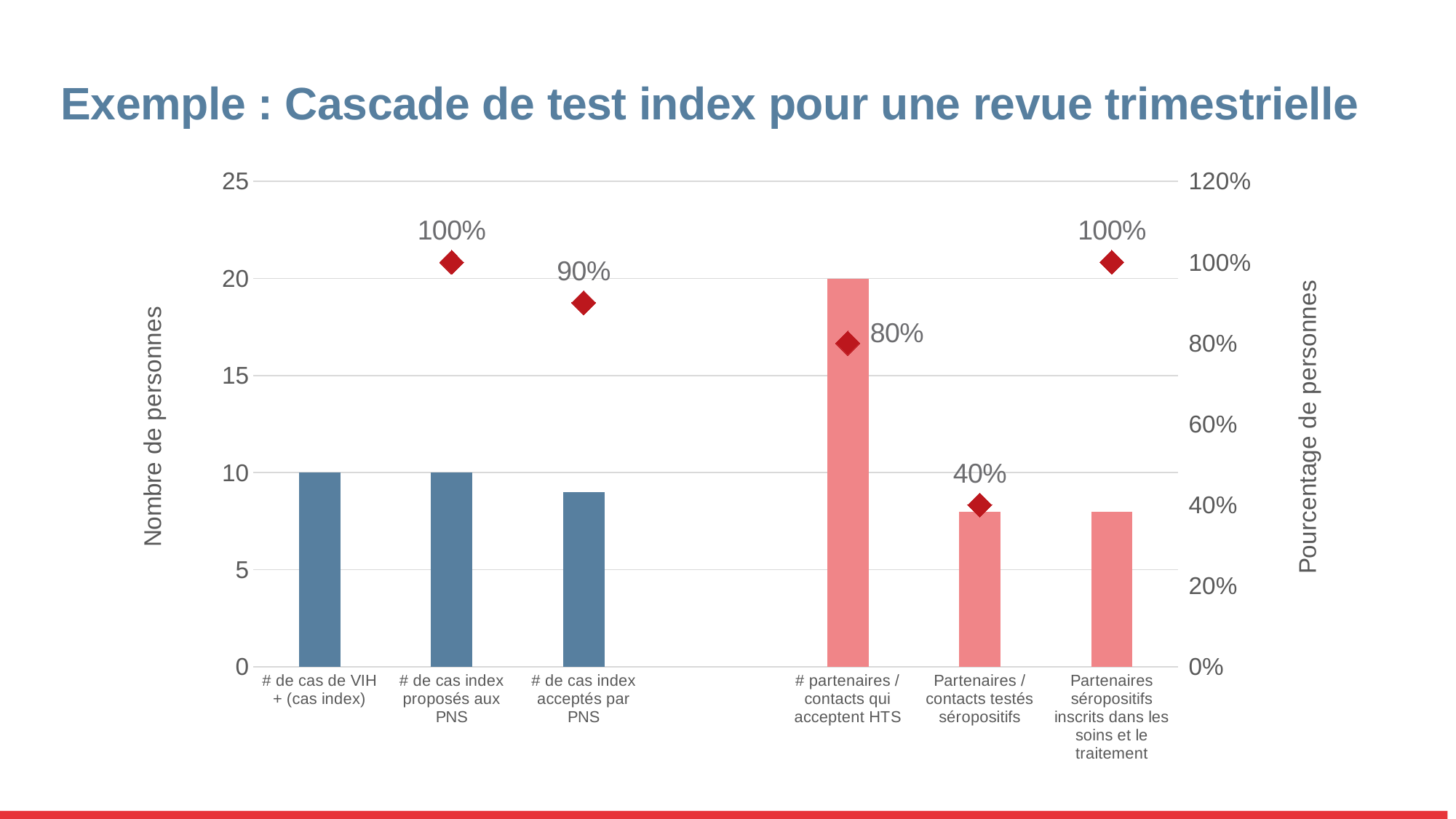
What is the title of the slide's chart? Exemple : Cascade de test index pour une revue trimestrielle What is the number of persons for '# partenaires / contacts qui acceptent HTS'? 20 How many categories are shown on the x axis? 6 What is the label of the right-hand vertical axis? Pourcentage de personnes What percentage is shown for '# de cas index acceptés par PNS'? 90% Is the number of persons for 'Partenaires séropositifs inscrits dans les soins et le traitement' greater or less than 10? less What is the number of persons for '# de cas de VIH + (cas index)'? 10 What percentage is shown for 'Partenaires / contacts testés séropositifs'? 40% What is the difference between the percentage for '# de cas index proposés aux PNS' and the percentage for 'Partenaires / contacts testés séropositifs'? 60% What percentage is shown for '# partenaires / contacts qui acceptent HTS'? 80% Which category has the tallest bar? # partenaires / contacts qui acceptent HTS What kind of chart is shown on the slide? bar chart with a line/marker series